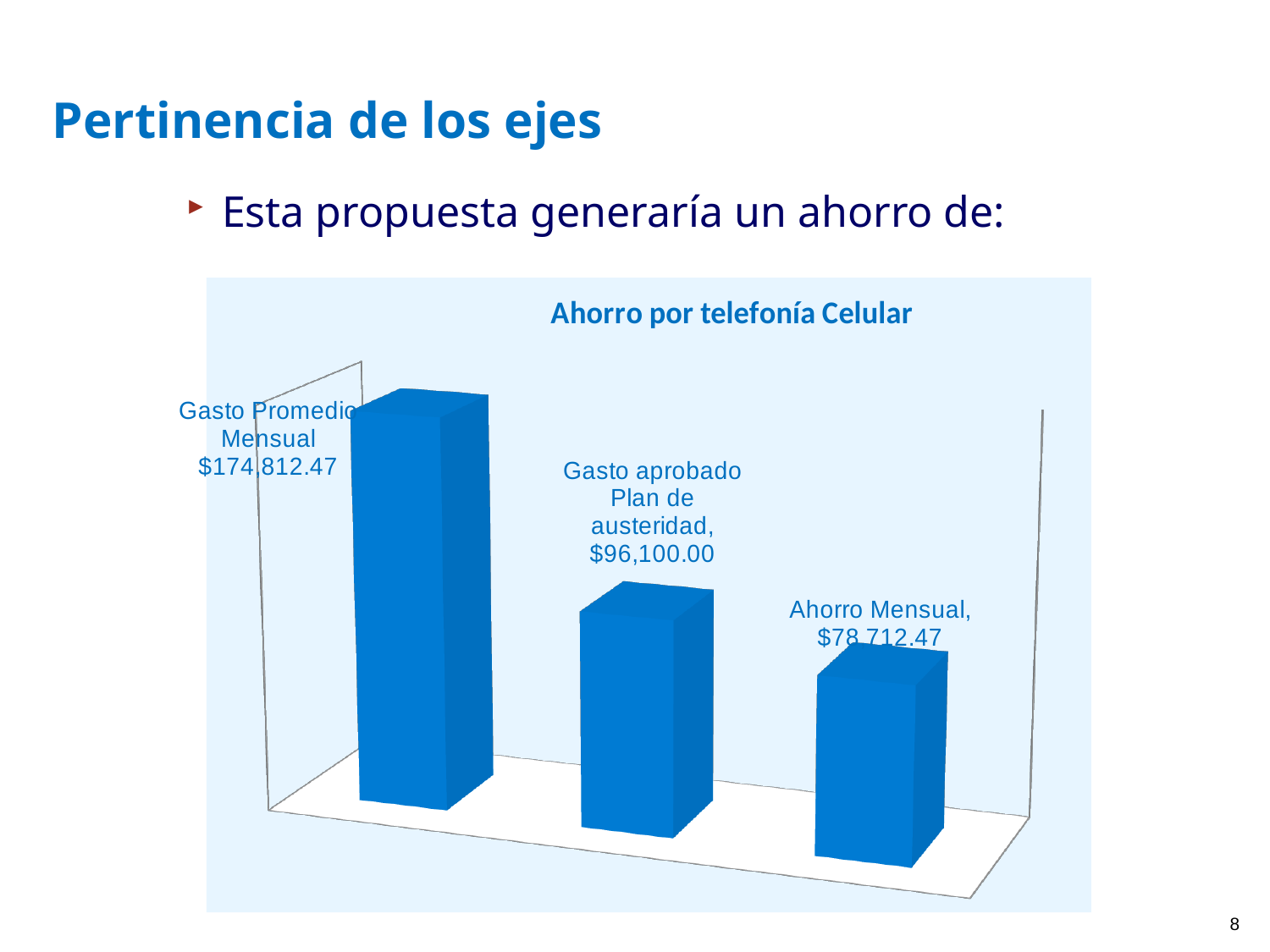
What is the title of the chart? Ahorro por telefonía Celular Which category has the lowest value? Ahorro Mensual What is the value for Ahorro Mensual? $78,712.47 What type of chart is shown on the slide? Bar chart What is the value for Gasto aprobado Plan de austeridad? $96,100.00 Which category has the highest value? Gasto Promedio Mensual What is the difference between Gasto aprobado Plan de austeridad and Ahorro Mensual? $17,387.53 Which is larger, Gasto aprobado Plan de austeridad or Ahorro Mensual? Gasto aprobado Plan de austeridad How many bars does the chart show? 3 What is the value for Gasto Promedio Mensual? $174,812.47 Do the bar values rise or fall from left to right across the chart? Fall What is the difference between Gasto Promedio Mensual and Gasto aprobado Plan de austeridad? $78,712.47